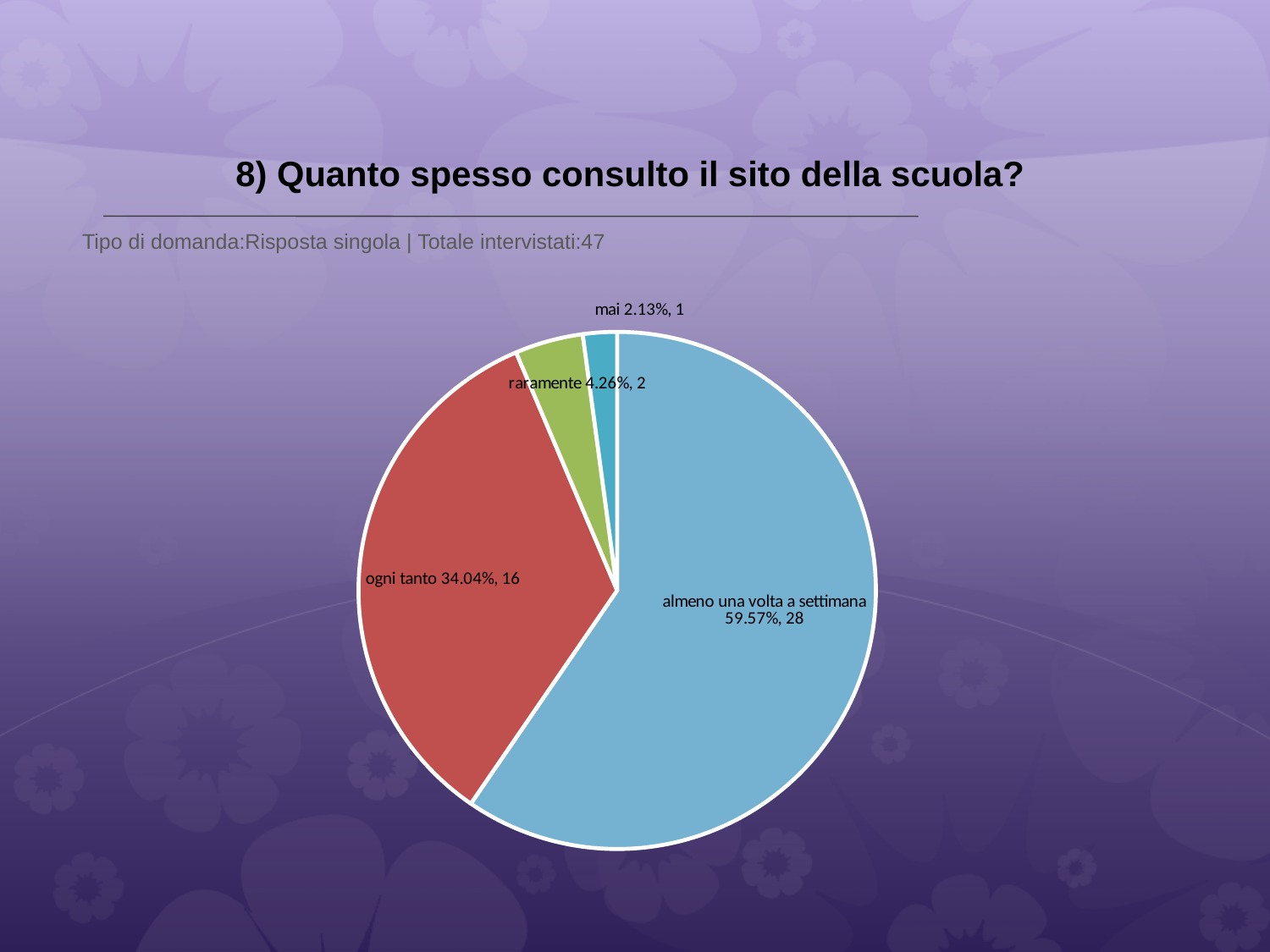
How many slices does the pie chart have? 4 What is the difference in respondent count between 'almeno una volta a settimana' and 'ogni tanto'? 12 Which category has the smallest slice? mai Which has more respondents, 'raramente' or 'mai'? raramente What percentage share does the 'raramente' slice have? 4.26% What percentage share does the 'almeno una volta a settimana' slice have? 59.57% What is the title of the slide? 8) Quanto spesso consulto il sito della scuola? How many respondents answered 'mai'? 1 What colour is the 'ogni tanto' slice? red How many respondents answered 'ogni tanto'? 16 Which category has the largest slice? almeno una volta a settimana What kind of chart is shown on the slide? pie chart